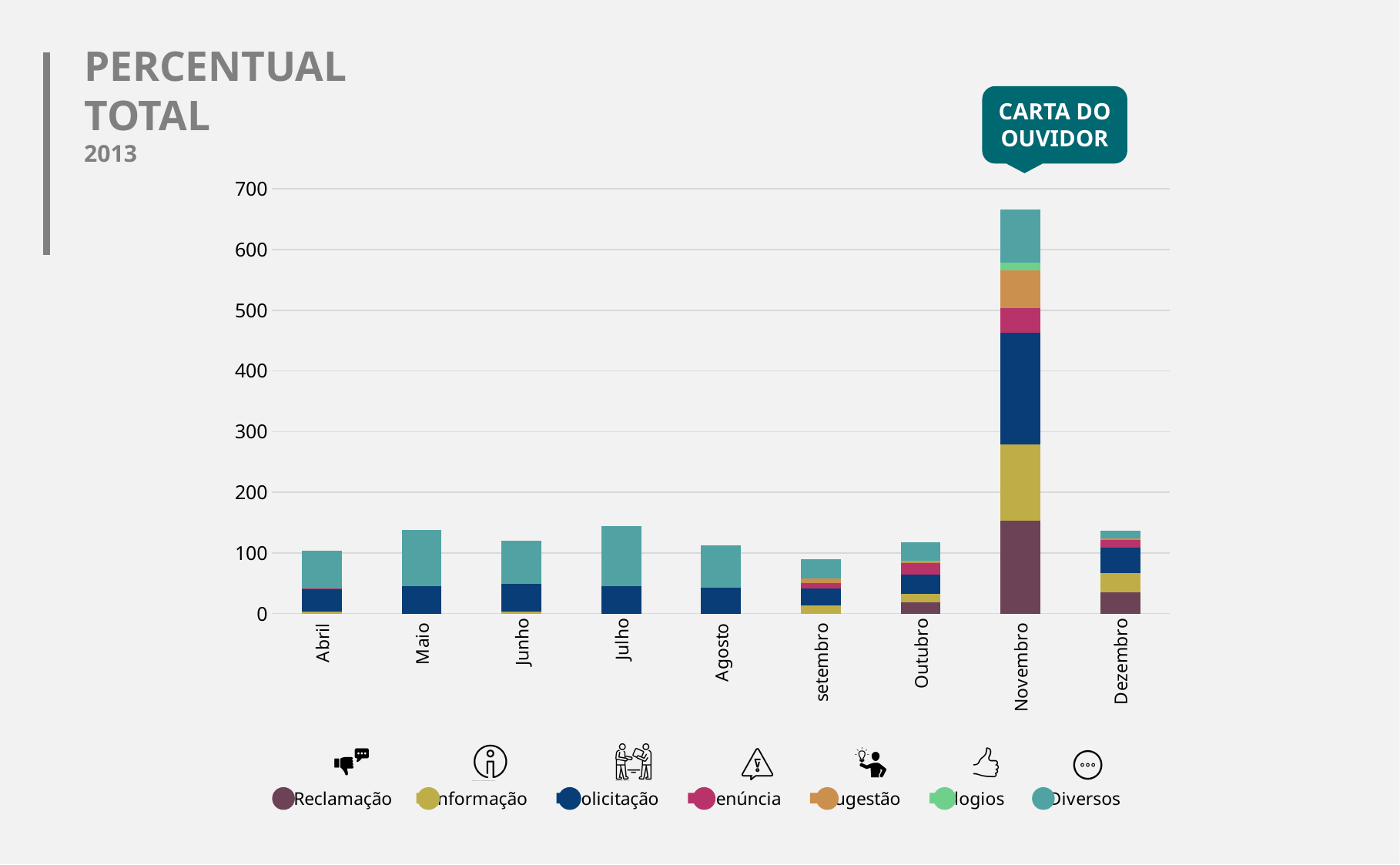
Which month has the larger total bar, Maio or Agosto? Maio How many series does the legend list? 7 Is the total value for setembro greater or less than 100? less What kind of chart is shown on the slide? Stacked bar chart Is the total value for Novembro greater or less than 600? greater Which month has the larger total bar, Julho or Junho? Julho What does the callout above the Novembro bar say? CARTA DO OUVIDOR Which month has the highest total bar? Novembro Which month has the lowest total bar? setembro Is the total value for Julho greater or less than 100? greater How many months are shown on the x axis of the chart? 9 What is the title of the chart on the slide? PERCENTUAL TOTAL